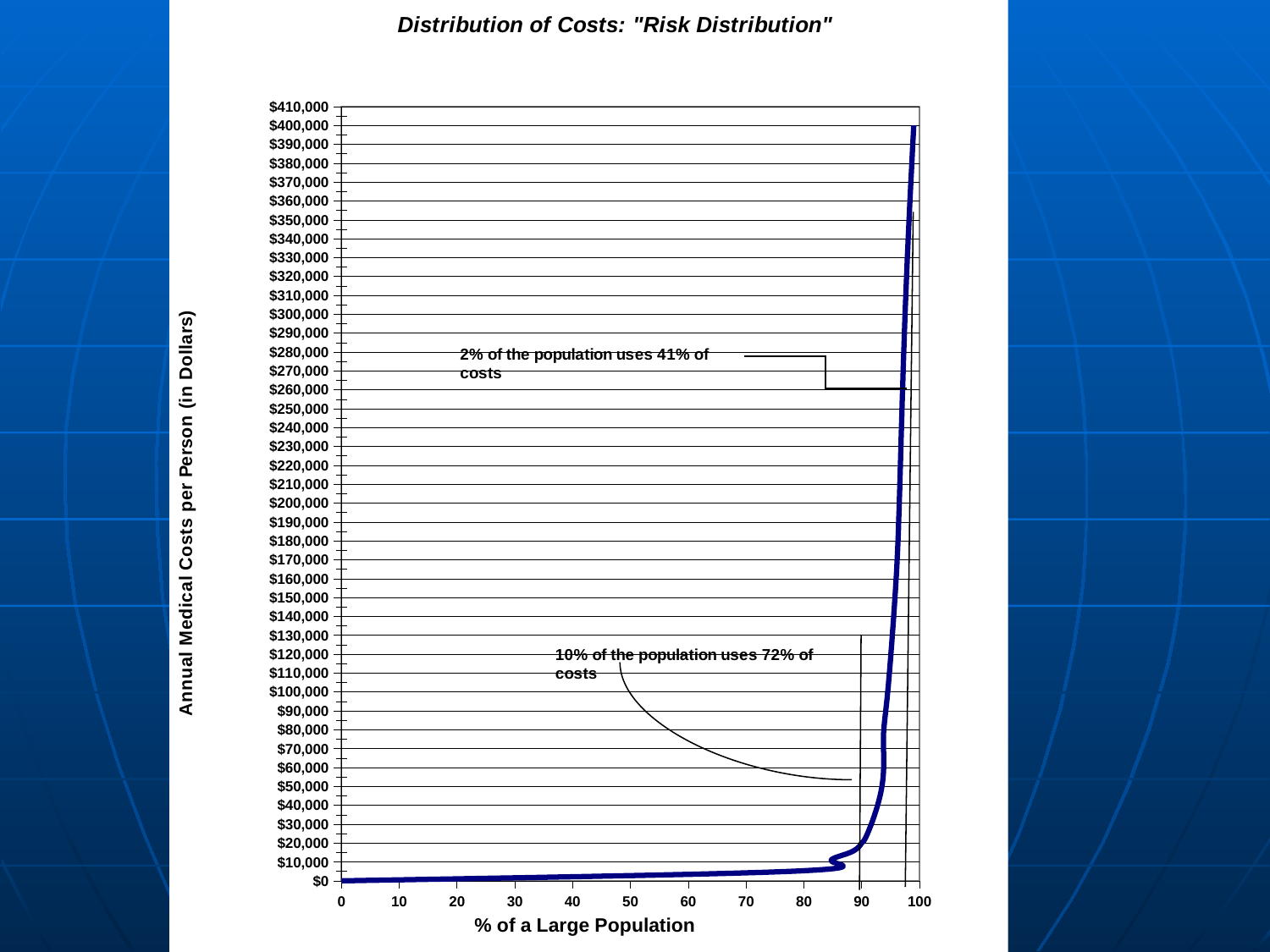
Is the annual medical cost per person at 80% of the population greater or less than $20,000? less Is the annual medical cost per person at 50% of the population greater or less than $50,000? less According to the annotation on the chart, what share of costs does 2% of the population use? 41% Is the annual medical cost per person at 100% of the population greater or less than $300,000? greater What kind of chart is shown on the slide? line chart Do the annual medical costs per person rise or fall as the % of the population increases along the x axis? rise What is the label of the x axis? % of a Large Population What is the highest value shown on the y axis? $410,000 What is the title of the chart? Distribution of Costs: "Risk Distribution" According to the annotation on the chart, what share of costs does 10% of the population use? 72% Which is larger, the annual medical cost per person at 20% of the population or at 98% of the population? 98% of the population